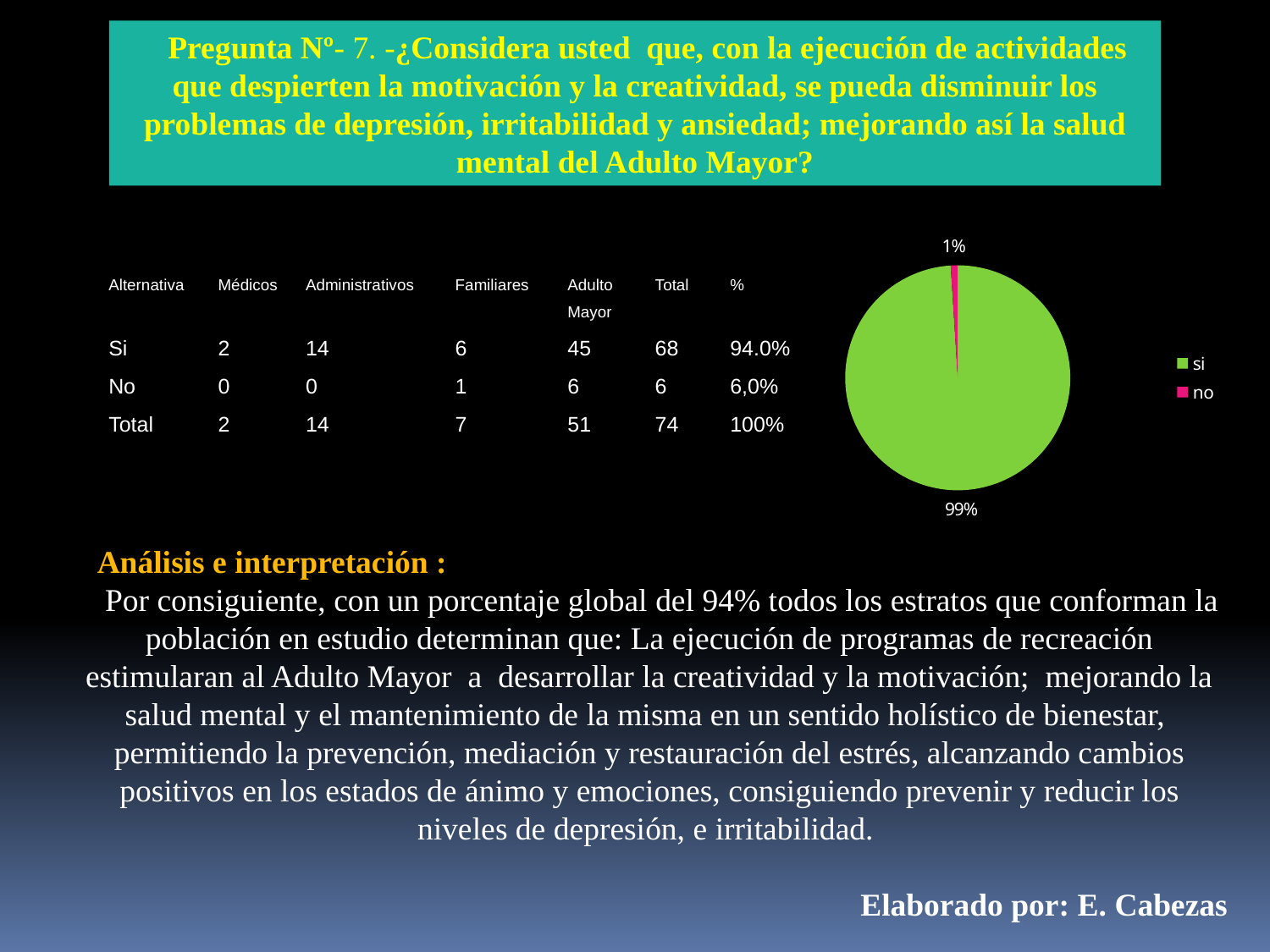
How many entries does the pie chart's legend list? 2 What colour is the "no" slice in the pie chart? pink Which slice of the pie chart is the smallest? no How many slices does the pie chart have? 2 What is the difference in percentage points between the "si" and "no" slices of the pie chart? 98 What percentage does the pie chart show for "si"? 99% Which slice of the pie chart is the largest? si What share of the pie does the "no" slice represent? 1% Which is larger in the pie chart, the "si" slice or the "no" slice? si What percentage does the pie chart show for "no"? 1% What kind of chart is shown on the slide? pie chart What colour is the "si" slice in the pie chart? green